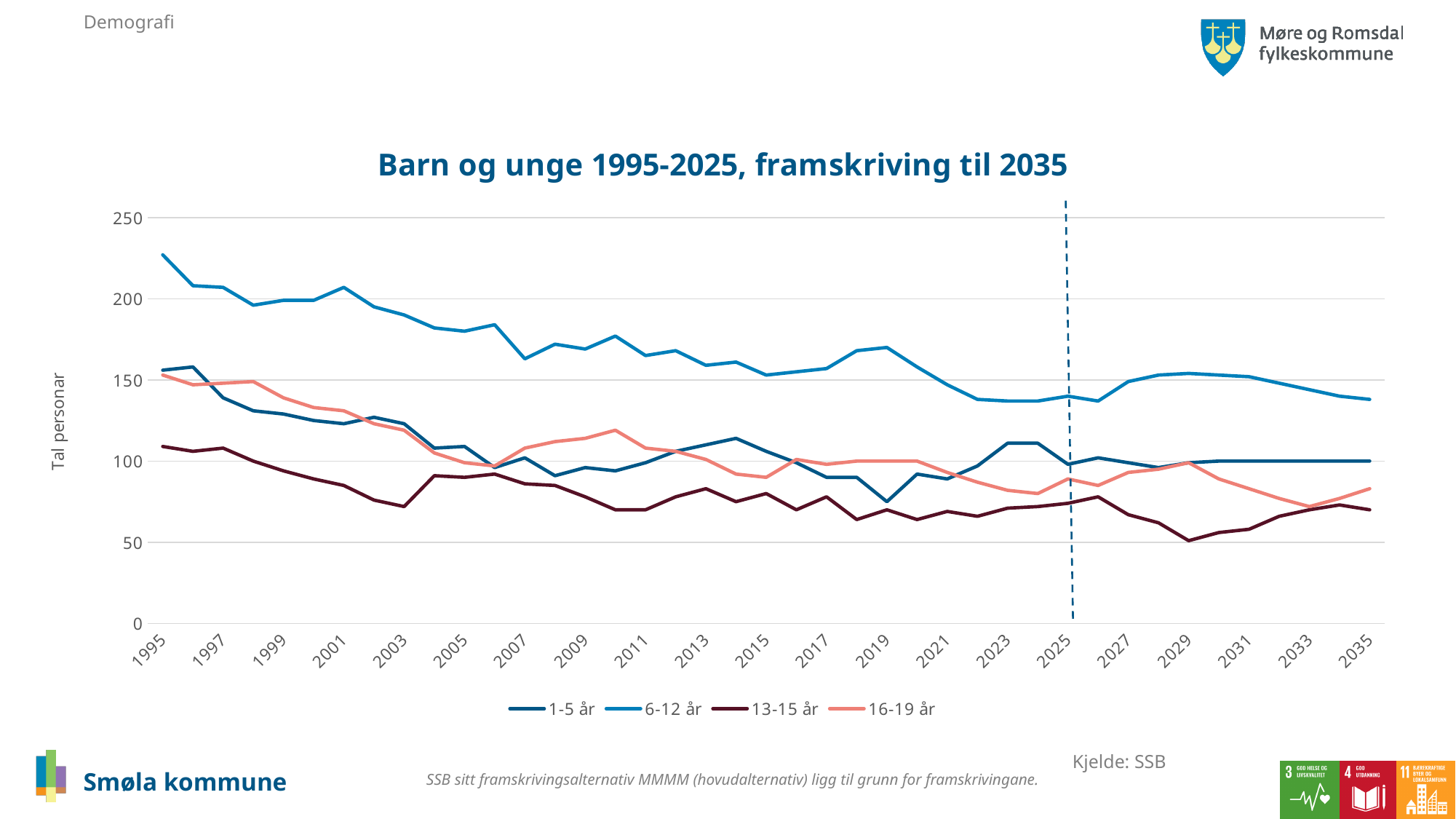
In 2025, which series is larger: 1-5 år or 13-15 år? 1-5 år Which series has the highest value in 1995? 6-12 år What is the label on the y axis? Tal personar Is the value for 6-12 år in 1995 greater or less than 200? greater Is the value for 16-19 år in 2010 greater or less than 100? greater What is the title of the chart? Barn og unge 1995-2025, framskriving til 2035 In 2035, which series is larger: 6-12 år or 1-5 år? 6-12 år Is the value for 6-12 år in 2035 greater or less than 150? less How many series does the legend list? 4 Does the 6-12 år series rise or fall overall from 1995 to 2035? fall Which series has the lowest value in 1995? 13-15 år What kind of chart is shown on the slide? line chart